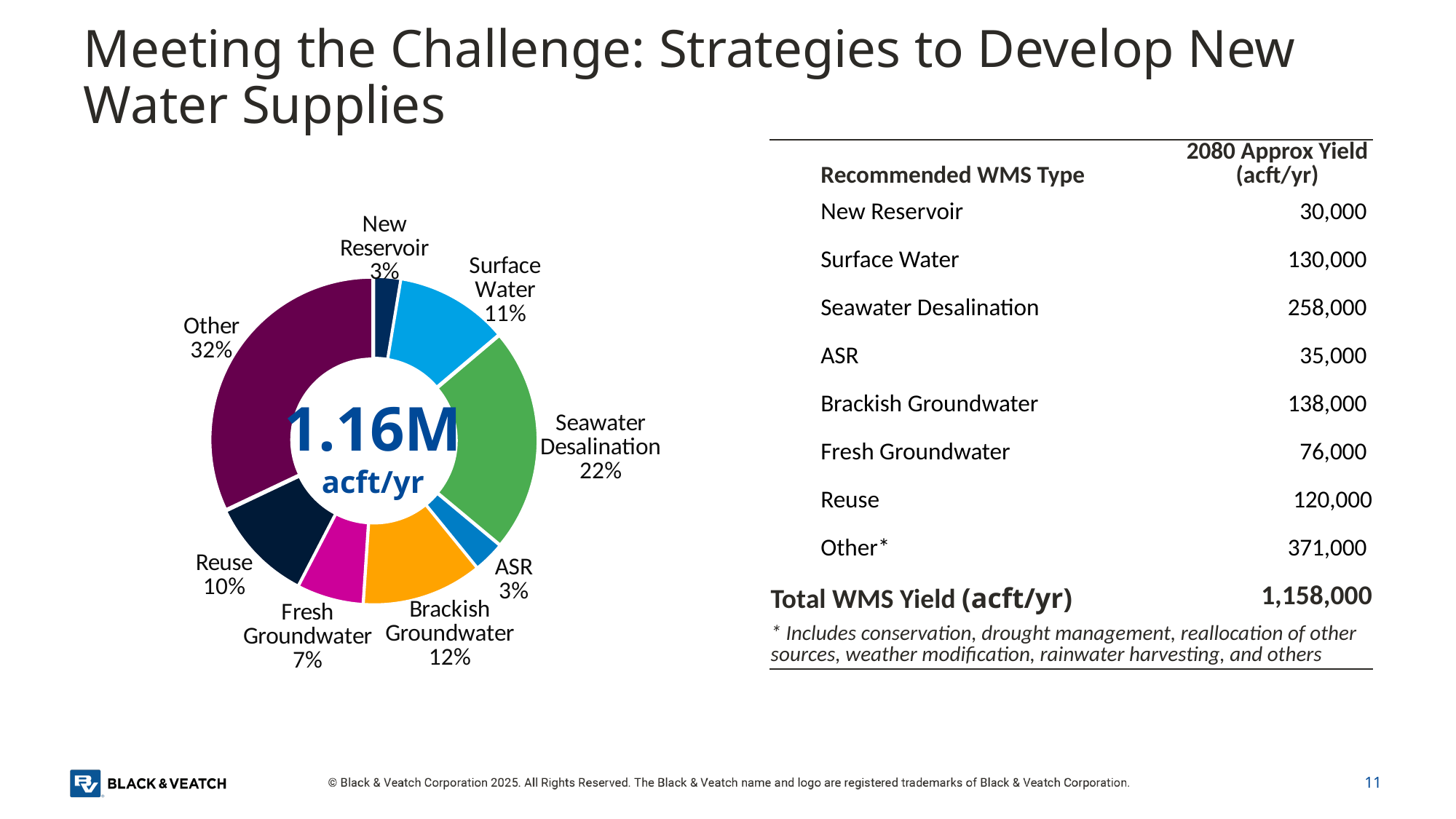
Which slice is larger in the pie chart, Surface Water or Reuse? Surface Water What percentage is shown for Brackish Groundwater in the pie chart? 12% What percentage is shown for ASR in the pie chart? 3% How many slices does the pie chart have? 8 What is the difference in percentage points between the Other slice and the Seawater Desalination slice? 10 What percentage is shown for Fresh Groundwater in the pie chart? 7% What is the difference in percentage points between Brackish Groundwater and Fresh Groundwater in the pie chart? 5 What total value is printed in the centre of the pie chart? 1.16M acft/yr What percentage is shown for Reuse in the pie chart? 10% What share of the pie chart does Seawater Desalination represent? 22% What kind of chart is shown on the left of the slide? Pie chart Which category has the largest slice in the pie chart? Other